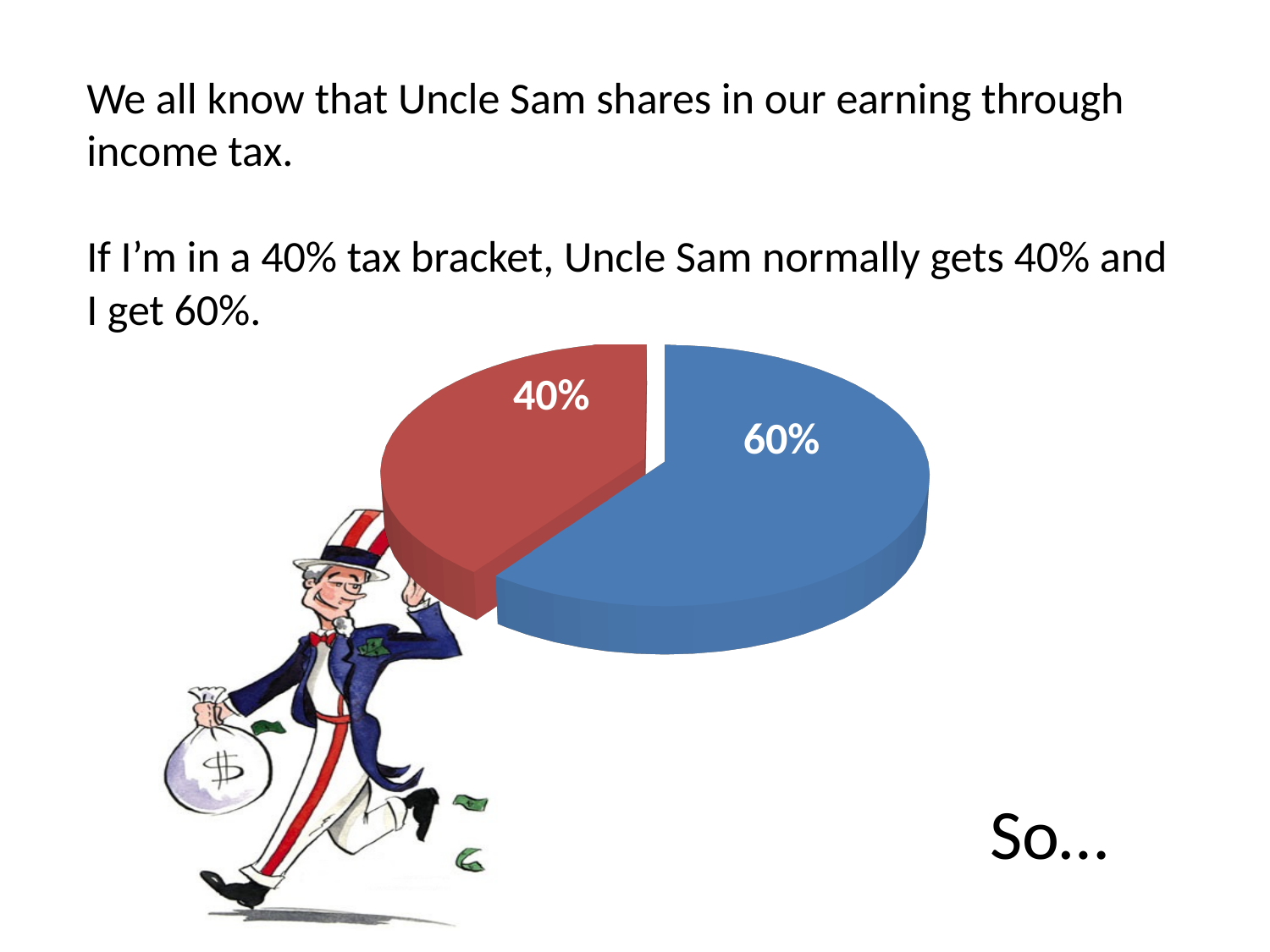
What value is labelled on the red slice of the pie chart? 40% Which is larger in the pie chart, the blue slice or the red slice? The blue slice Which slice of the pie chart is the smallest? The red slice (40%) Which slice of the pie chart is the largest? The blue slice (60%) What value is labelled on the blue slice of the pie chart? 60% What kind of chart is shown on the slide? Pie chart According to the slide, what share of earnings does Uncle Sam get in a 40% tax bracket? 40% What do the two slices of the pie chart add up to? 100% How many slices does the pie chart have? 2 What share of the pie does the red slice represent? 40% What colour is the slice representing the 60% share? Blue What is the difference between the blue slice and the red slice in the pie chart? 20 percentage points